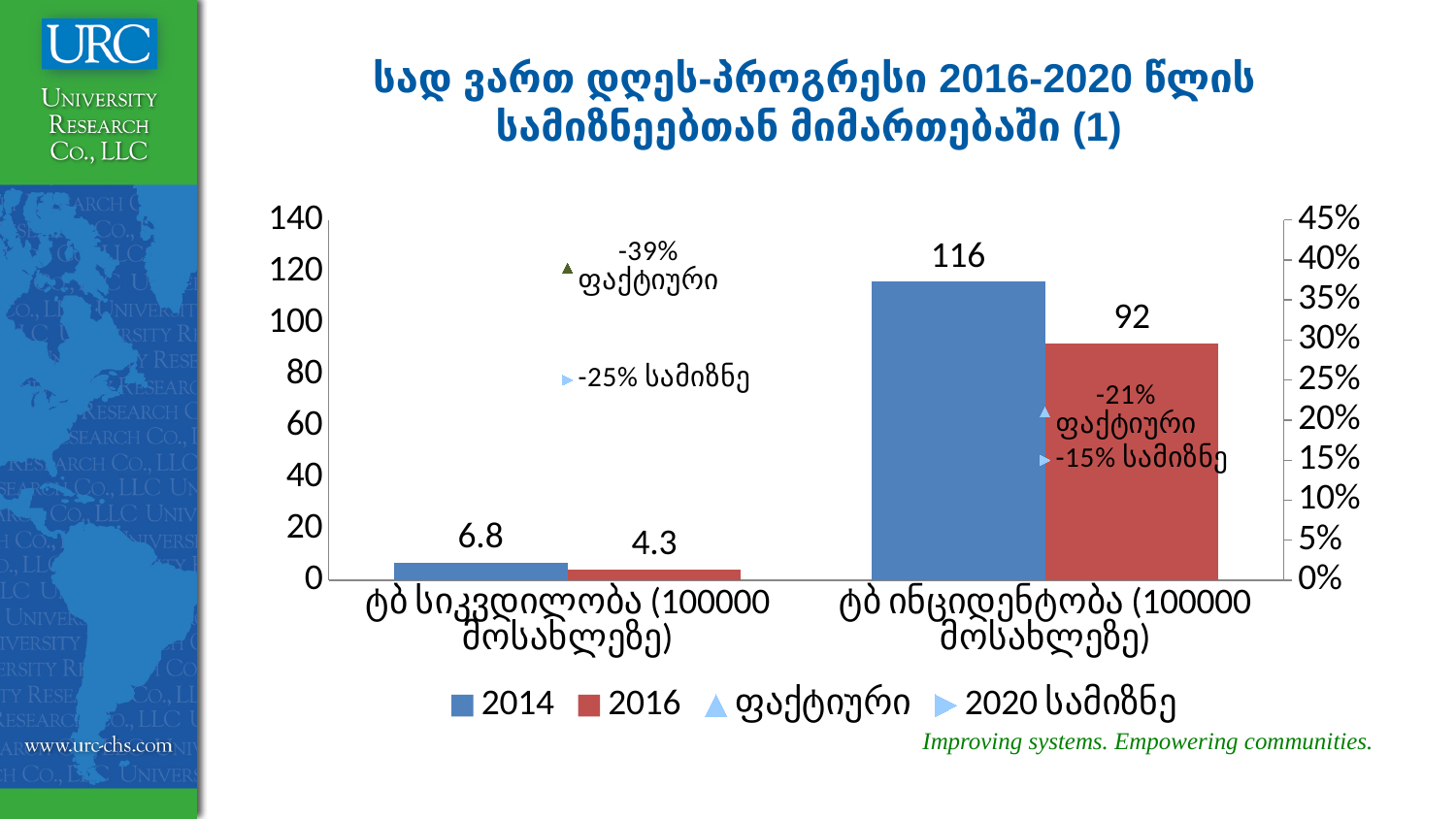
What type of chart is used to show the 2014 and 2016 values? Bar chart What is the 2020 სამიზნე percentage shown for ტბ ინციდენტობა (100000 მოსახლეზე)? -15% What is the 2014 value for ტბ სიკვდილობა (100000 მოსახლეზე)? 6.8 What is the 2014 value for ტბ ინციდენტობა (100000 მოსახლეზე)? 116 What is the ფაქტიური percentage shown for ტბ სიკვდილობა (100000 მოსახლეზე)? -39% What is the difference between the 2014 and 2016 values for ტბ ინციდენტობა (100000 მოსახლეზე)? 24 How many categories are shown on the x axis of the chart? 2 Which is larger for ტბ ინციდენტობა (100000 მოსახლეზე), the 2014 value or the 2016 value? 2014 How many series does the chart legend list? 4 What is the 2016 value for ტბ სიკვდილობა (100000 მოსახლეზე)? 4.3 What is the difference between the 2014 and 2016 values for ტბ სიკვდილობა (100000 მოსახლეზე)? 2.5 What is the 2016 value for ტბ ინციდენტობა (100000 მოსახლეზე)? 92